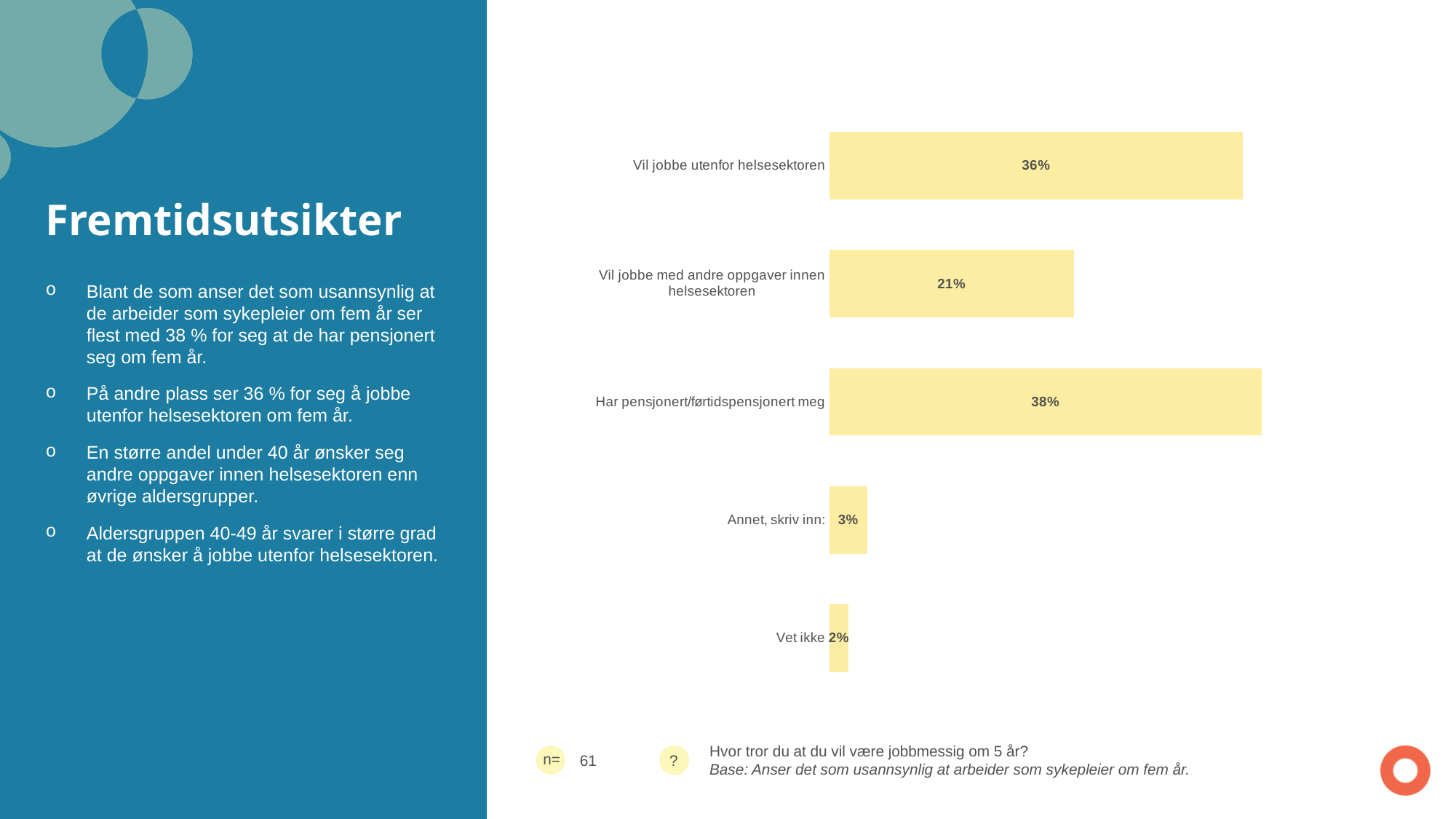
Which category has the highest value? Har pensjonert/førtidspensjonert meg What is the value for "Vet ikke"? 2% What kind of chart is shown on the slide? Bar chart What is the value for "Har pensjonert/førtidspensjonert meg"? 38% What is the difference between "Vil jobbe utenfor helsesektoren" and "Vil jobbe med andre oppgaver innen helsesektoren"? 15% Which category has the lowest value? Vet ikke How many categories are shown in the chart? 5 What is the value for "Vil jobbe utenfor helsesektoren"? 36% What is the sample size (n) shown below the chart? 61 What is the value for "Vil jobbe med andre oppgaver innen helsesektoren"? 21% What is the difference between "Har pensjonert/førtidspensjonert meg" and "Vil jobbe utenfor helsesektoren"? 2% Which is larger: "Vil jobbe med andre oppgaver innen helsesektoren" or "Annet, skriv inn:"? Vil jobbe med andre oppgaver innen helsesektoren